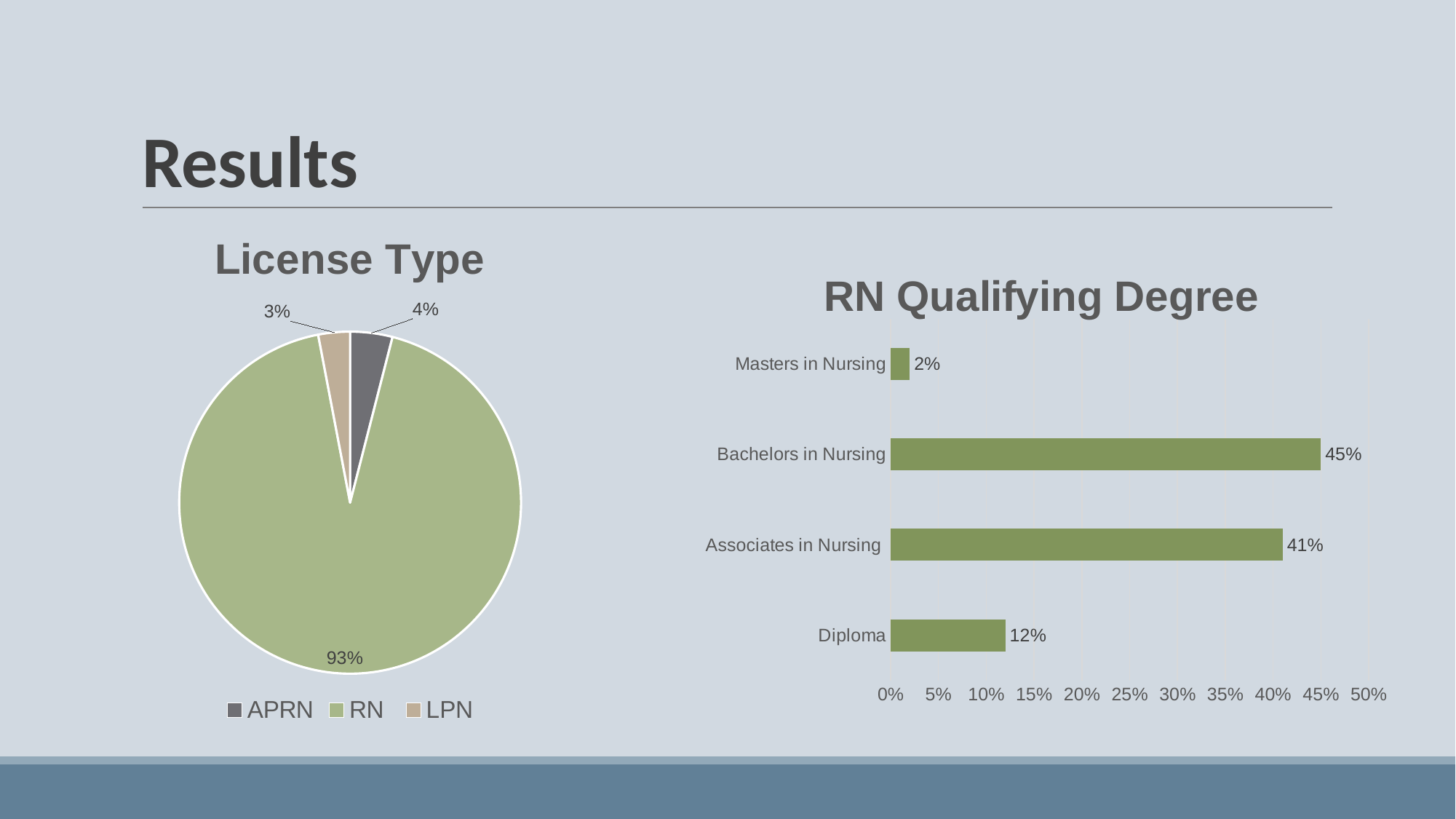
In the License Type chart, what share of the pie is APRN? 4% In the License Type chart, which license type has the largest slice? RN In the RN Qualifying Degree chart, what is the difference between Bachelors in Nursing and Associates in Nursing? 4% In the RN Qualifying Degree chart, how many categories are shown? 4 In the License Type chart, what share of the pie is RN? 93% In the License Type chart, how many entries does the legend list? 3 What kind of chart is the License Type chart? Pie chart In the RN Qualifying Degree chart, what is the value for Diploma? 12% What kind of chart is the RN Qualifying Degree chart? Bar chart In the RN Qualifying Degree chart, which degree has the lowest value? Masters in Nursing In the License Type chart, what share of the pie is LPN? 3% In the RN Qualifying Degree chart, what is the value for Bachelors in Nursing? 45%